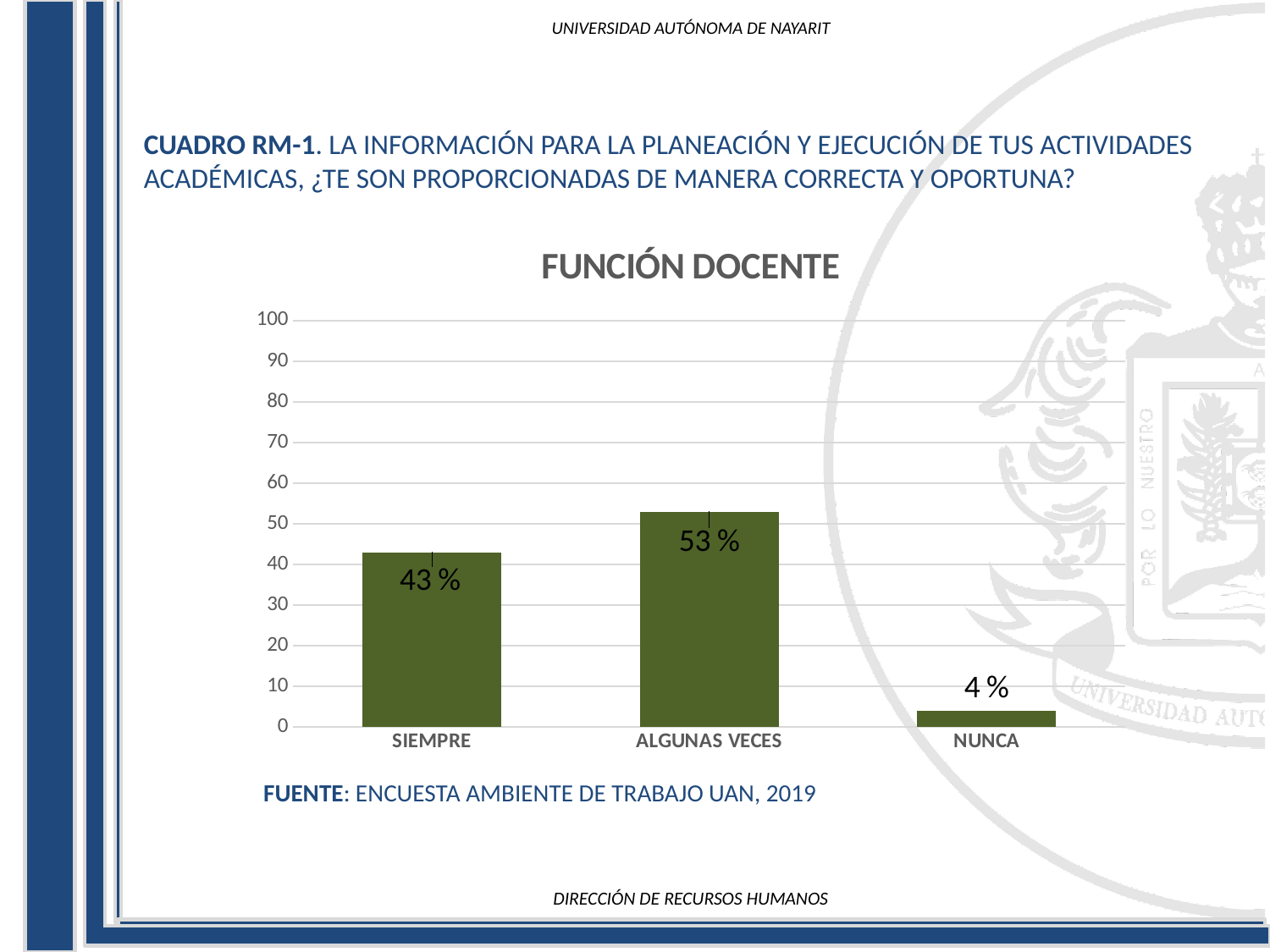
Is the value for NUNCA greater or less than 10? less What is the value for NUNCA? 4 % How many categories are shown on the x axis? 3 Which category has the lowest value? NUNCA What is the value for SIEMPRE? 43 % What is the value for ALGUNAS VECES? 53 % Which category has the highest value? ALGUNAS VECES What kind of chart is shown on the slide? bar chart What is the difference between the values for ALGUNAS VECES and SIEMPRE? 10 % Is the value for ALGUNAS VECES greater or less than 50? greater What is the title of the chart? FUNCIÓN DOCENTE Which is larger, the value for SIEMPRE or the value for NUNCA? SIEMPRE